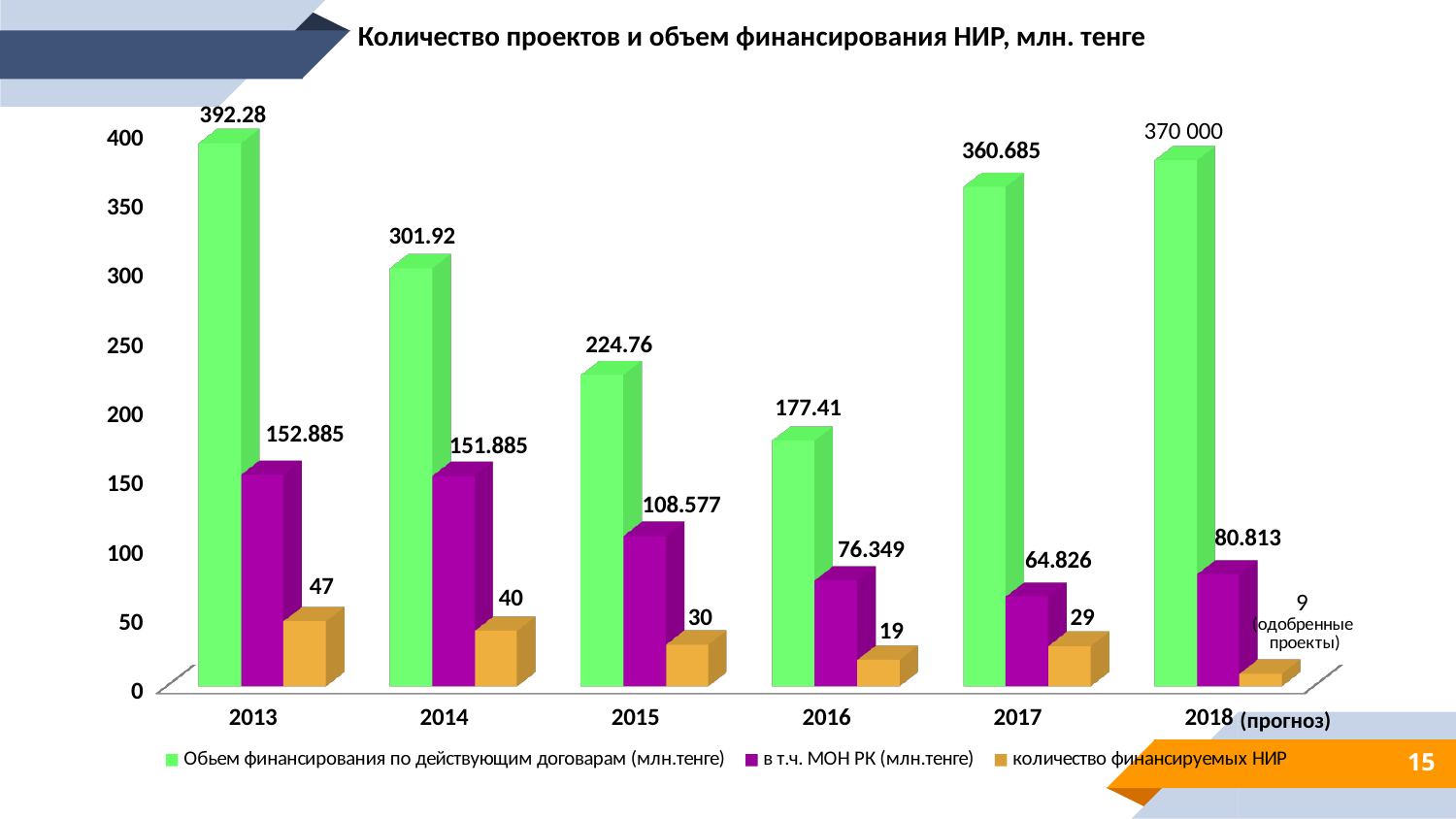
Which year has the highest value for 'количество финансируемых НИР'? 2013 What is the value of 'в т.ч. МОН РК (млн.тенге)' for 2018 (прогноз)? 80.813 How many years are shown on the x axis? 6 What is the value of 'в т.ч. МОН РК (млн.тенге)' for 2015? 108.577 What is the value of 'Обьем финансирования по действующим договарам (млн.тенге)' for 2013? 392.28 Does 'количество финансируемых НИР' rise or fall from 2013 to 2016? fall Which is larger: 'в т.ч. МОН РК (млн.тенге)' in 2015 or in 2016? 2015 What is the difference between 'количество финансируемых НИР' in 2013 and in 2016? 28 Which year has the lowest value for 'Обьем финансирования по действующим договарам (млн.тенге)'? 2016 What is the difference between 'Обьем финансирования по действующим договарам (млн.тенге)' in 2013 and in 2014? 90.36 What is the value of 'количество финансируемых НИР' for 2017? 29 How many series does the legend list? 3